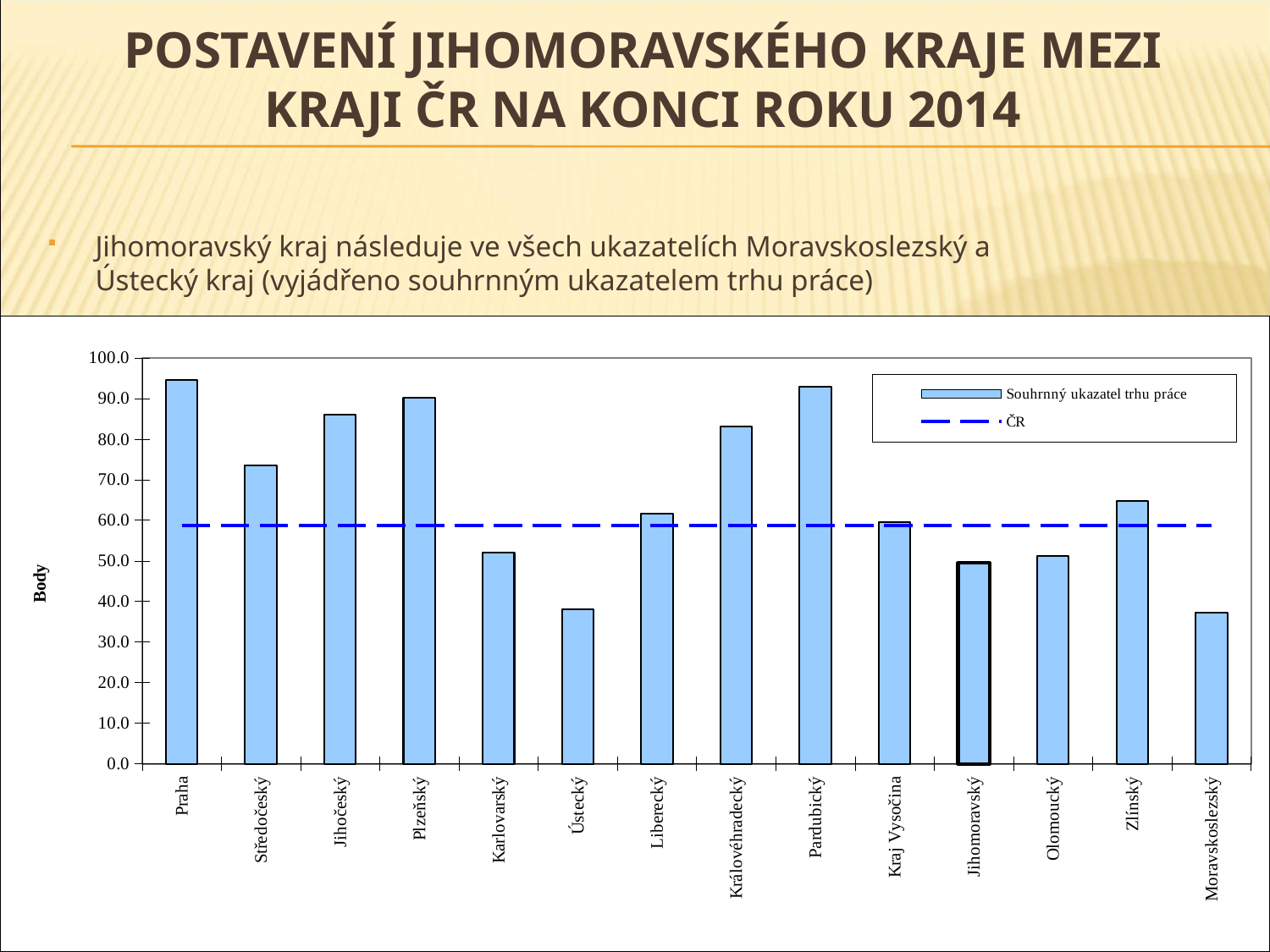
Is the value for Praha greater or less than 90? greater Is the value for Královéhradecký greater or less than 80? greater Is the value for Jihomoravský greater or less than 60? less Which has the larger value, Karlovarský or Ústecký? Karlovarský What is the label on the vertical axis of the chart? Body What kind of chart is shown on the slide? bar chart Which has the larger value, Jihočeský or Středočeský? Jihočeský How many entries does the chart's legend list? 2 How many regions (categories) are plotted on the x axis of the chart? 14 Which region's bar is outlined with a thick black border in the chart? Jihomoravský